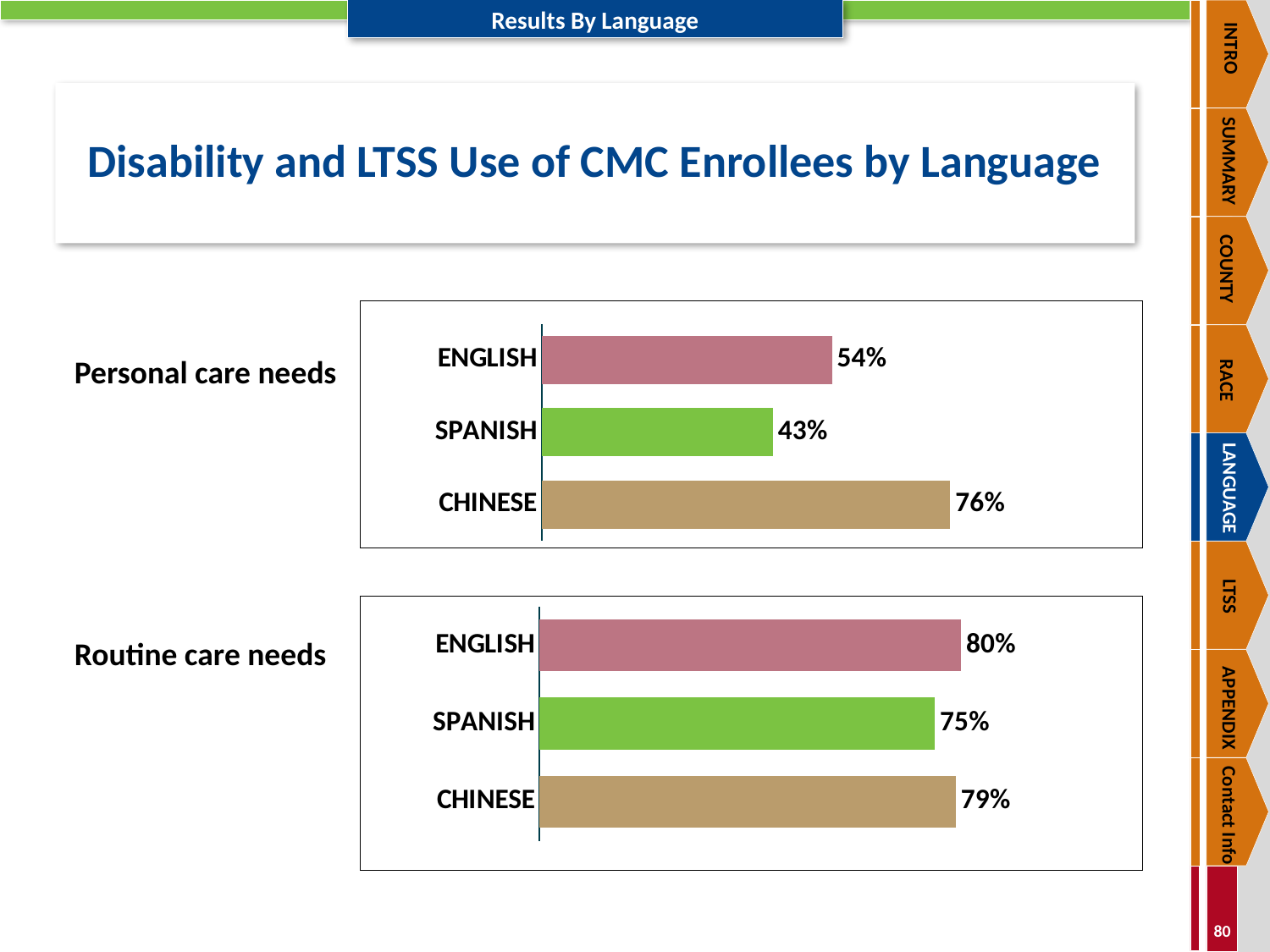
In the Routine care needs chart, what is the value for SPANISH? 75% How many language categories are shown in the Personal care needs chart? 3 In the Routine care needs chart, which language has the lowest value? SPANISH What kind of chart is the Routine care needs chart? Bar chart In the Personal care needs chart, what is the difference between the CHINESE and SPANISH values? 33% In the Personal care needs chart, what is the value for SPANISH? 43% In the Routine care needs chart, which is larger, the value for ENGLISH or the value for SPANISH? ENGLISH In the Personal care needs chart, what is the value for ENGLISH? 54% In the Personal care needs chart, which language has the highest value? CHINESE In the Personal care needs chart, which language has the lowest value? SPANISH In the Routine care needs chart, what is the value for CHINESE? 79% In the Routine care needs chart, what is the difference between the ENGLISH and SPANISH values? 5%